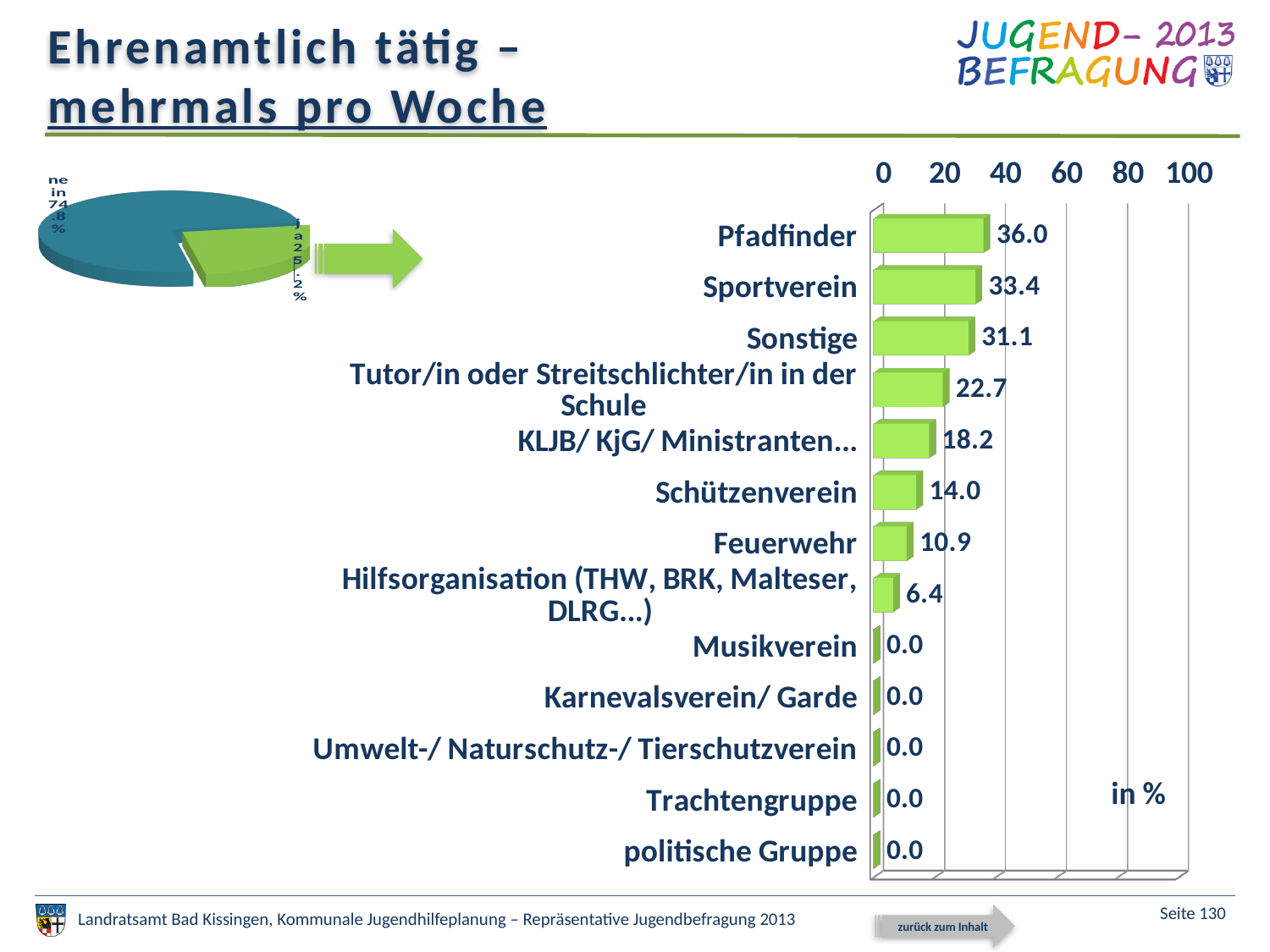
How many categories in the bar chart have a value of 0.0? 5 In the bar chart, what is the value for Pfadfinder? 36.0 In the bar chart, what is the value for Tutor/in oder Streitschlichter/in in der Schule? 22.7 In the bar chart, what unit is indicated by the label near the axis? in % In the bar chart, which has the larger value, Schützenverein or Feuerwehr? Schützenverein In the bar chart, what is the value for Feuerwehr? 10.9 In the bar chart, which category has the highest value? Pfadfinder In the bar chart, is the value for Sonstige greater or less than 20? greater What kind of chart is the large chart on the right side of the slide? bar chart In the bar chart, what is the value for Hilfsorganisation (THW, BRK, Malteser, DLRG...)? 6.4 How many categories are shown in the bar chart? 13 In the bar chart, what is the difference between the values for Pfadfinder and Sportverein? 2.6